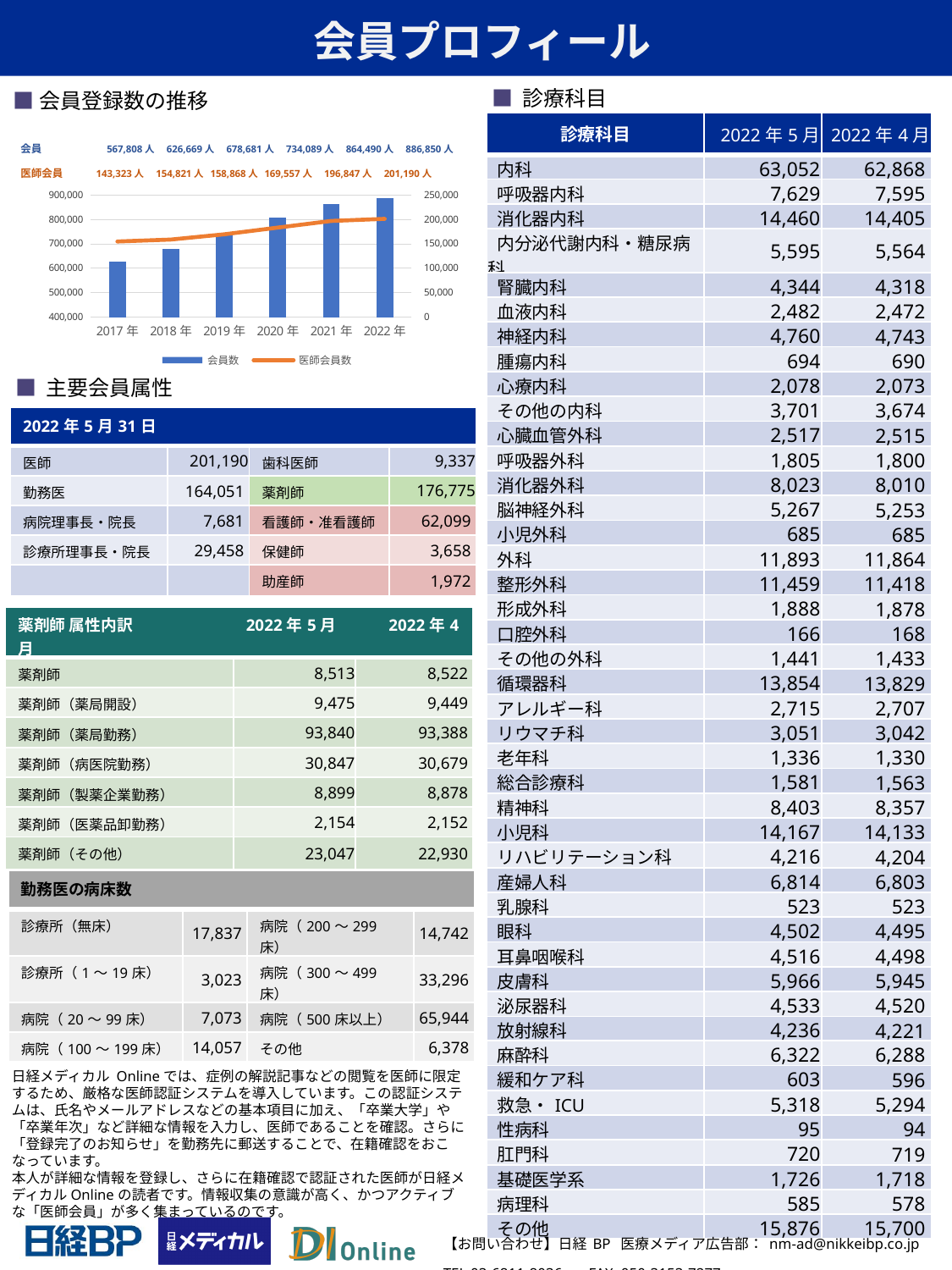
In the 会員登録数の推移 chart, what is the 医師会員 value for 2021年? 196,847人 In the 会員登録数の推移 chart, what is the difference between the 医師会員 values for 2022年 and 2021年? 4,343人 Do the 会員 values in the 会員登録数の推移 chart rise or fall from 2017年 to 2022年? rise In the 会員登録数の推移 chart, which year has the lowest 医師会員 value? 2017年 In the 会員登録数の推移 chart, is the 会員 value for 2018年 larger or smaller than the 会員 value for 2019年? smaller In the 会員登録数の推移 chart, which year has the highest 会員 value? 2022年 In the 会員登録数の推移 chart, what is the 会員 value for 2022年? 886,850人 How many years are shown on the x axis of the 会員登録数の推移 chart? 6 How many series does the legend of the 会員登録数の推移 chart list? 2